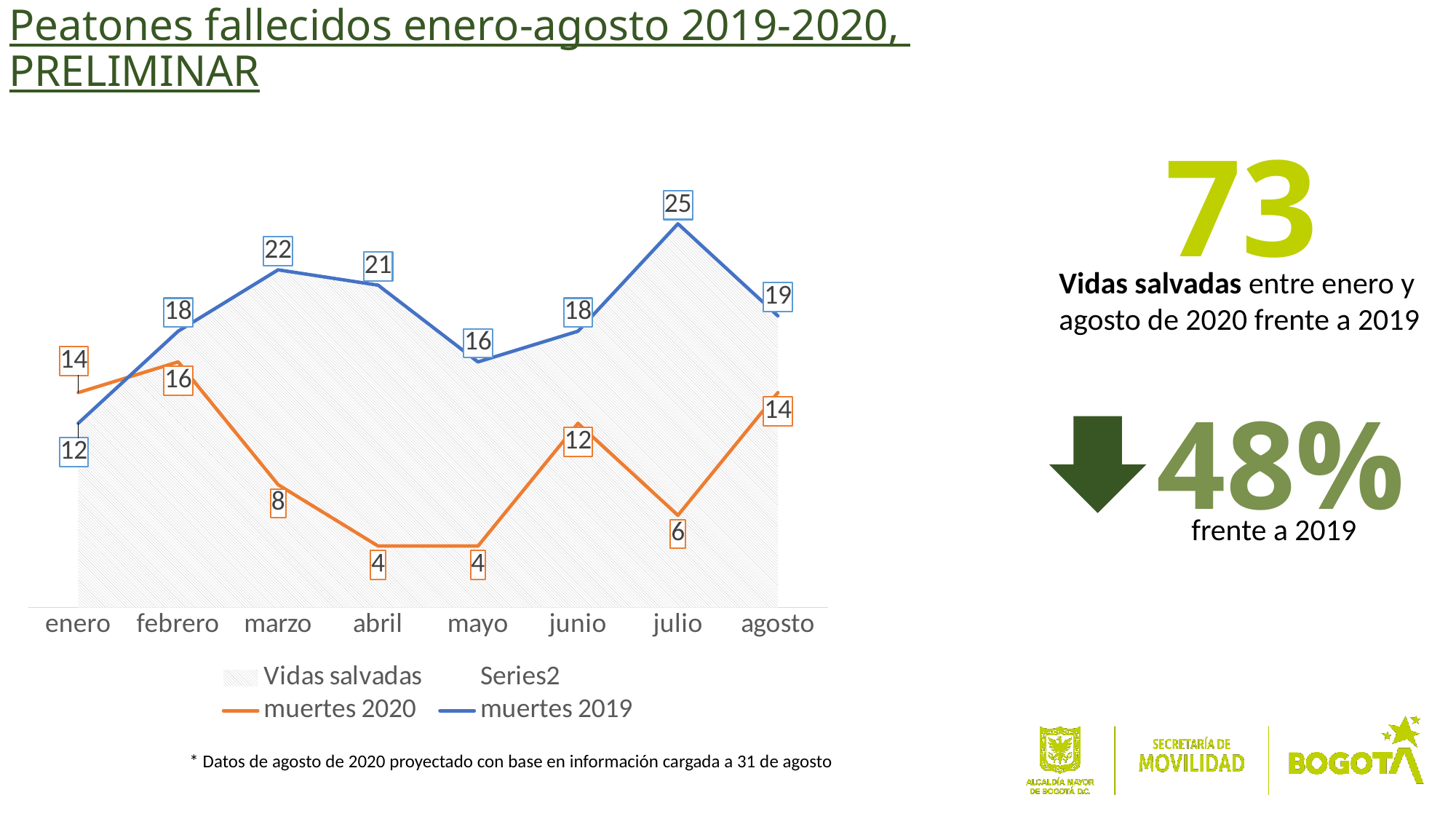
Does muertes 2020 rise or fall from febrero to abril? fall How many entries does the legend list? 4 What is the value for muertes 2020 in marzo? 8 Which is larger in enero, muertes 2019 or muertes 2020? muertes 2020 In which month is muertes 2020 lowest? abril and mayo What is the difference between muertes 2019 and muertes 2020 in julio? 19 In which month is muertes 2019 highest? julio What is the value for muertes 2019 in julio? 25 How many months are shown on the x axis? 8 What is the value for muertes 2019 in enero? 12 What is the difference between muertes 2019 in marzo and muertes 2019 in mayo? 6 What kind of chart is shown on the slide? combination area and line chart